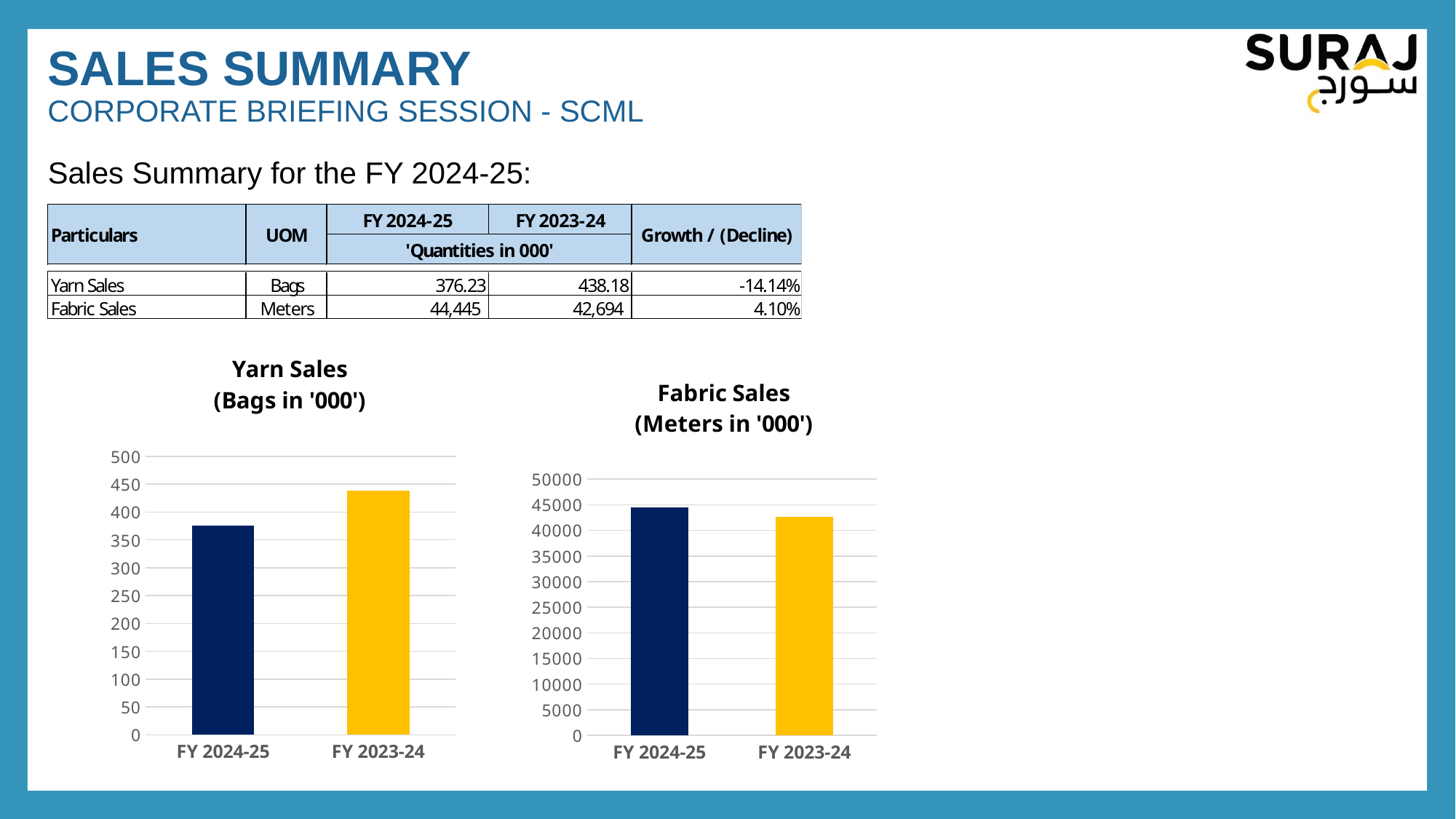
In the Fabric Sales chart, is the FY 2024-25 bar larger or smaller than the FY 2023-24 bar? larger In the Fabric Sales chart, is the value for FY 2024-25 greater or less than 45000? less In the Yarn Sales chart, which fiscal year has the higher bar? FY 2023-24 In the Yarn Sales chart, is the value for FY 2023-24 greater or less than 400? greater In the Fabric Sales chart, which fiscal year has the lower bar? FY 2023-24 What is the Yarn Sales quantity for FY 2024-25 as printed in the table on the slide? 376.23 What kind of chart is the Yarn Sales chart? bar chart In the Yarn Sales chart, is the value for FY 2024-25 greater or less than 400? less What is the Fabric Sales quantity for FY 2023-24 as printed in the table on the slide? 42,694 What unit is given in the title of the Fabric Sales chart? Meters in '000' How many bars are shown in the Fabric Sales chart? 2